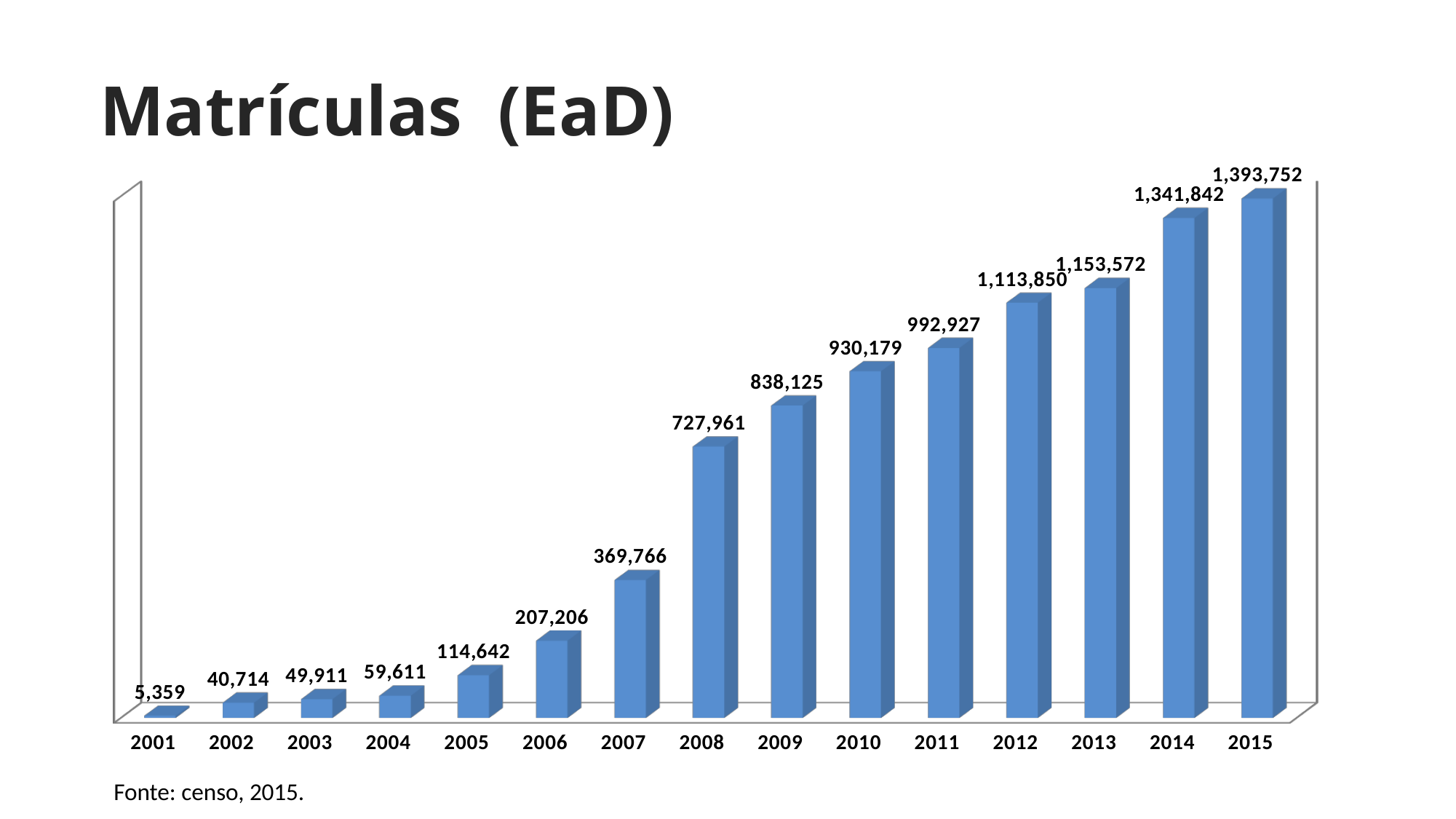
What is the title of the chart? Matrículas (EaD) Which is larger, the value for 2009 or the value for 2010? 2010 Do the values rise or fall from 2001 to 2015? Rise What is the difference between the values for 2015 and 2014? 51,910 What is the value for 2008? 727,961 What kind of chart is this? Bar chart How many years are shown on the x axis? 15 What is the value for 2001? 5,359 Which year has the highest value? 2015 What is the difference between the values for 2008 and 2007? 358,195 Which year has the lowest value? 2001 What is the value for 2012? 1,113,850